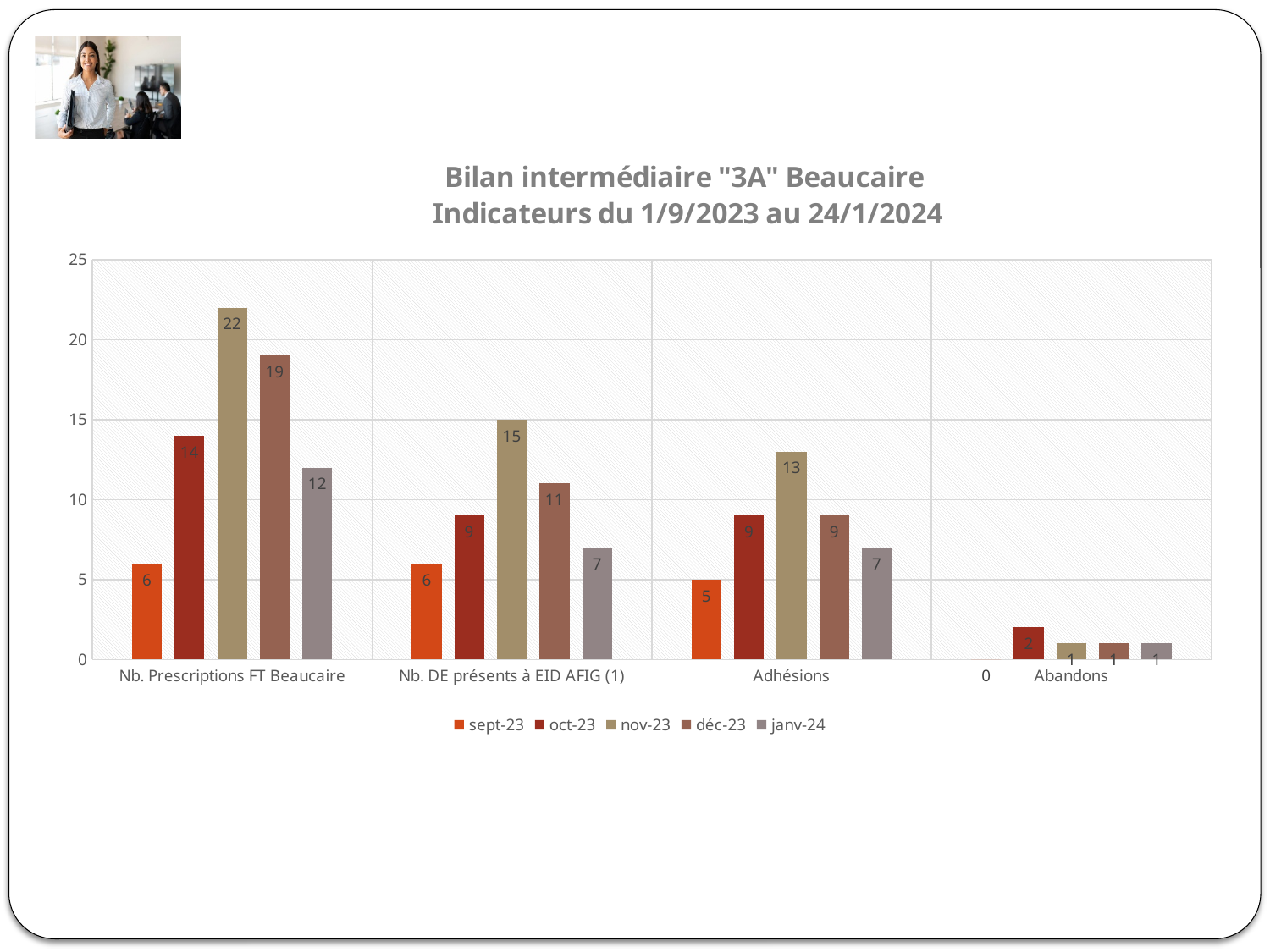
How many categories are shown on the x axis? 4 Which series has the lowest value in the Adhésions category? sept-23 What is the value for déc-23 in the Adhésions category? 9 Which series has the highest value in the Nb. Prescriptions FT Beaucaire category? nov-23 What is the value for nov-23 in the Nb. Prescriptions FT Beaucaire category? 22 Which is larger: the oct-23 value for Nb. Prescriptions FT Beaucaire or the nov-23 value for Adhésions? oct-23 value for Nb. Prescriptions FT Beaucaire How many series does the legend list? 5 What is the value for oct-23 in the Abandons category? 2 What is the value for janv-24 in the Nb. DE présents à EID AFIG (1) category? 7 What is the difference between the nov-23 and déc-23 values in the Nb. DE présents à EID AFIG (1) category? 4 What is the title of the chart? Bilan intermédiaire "3A" Beaucaire Indicateurs du 1/9/2023 au 24/1/2024 What kind of chart is shown on the slide? bar chart